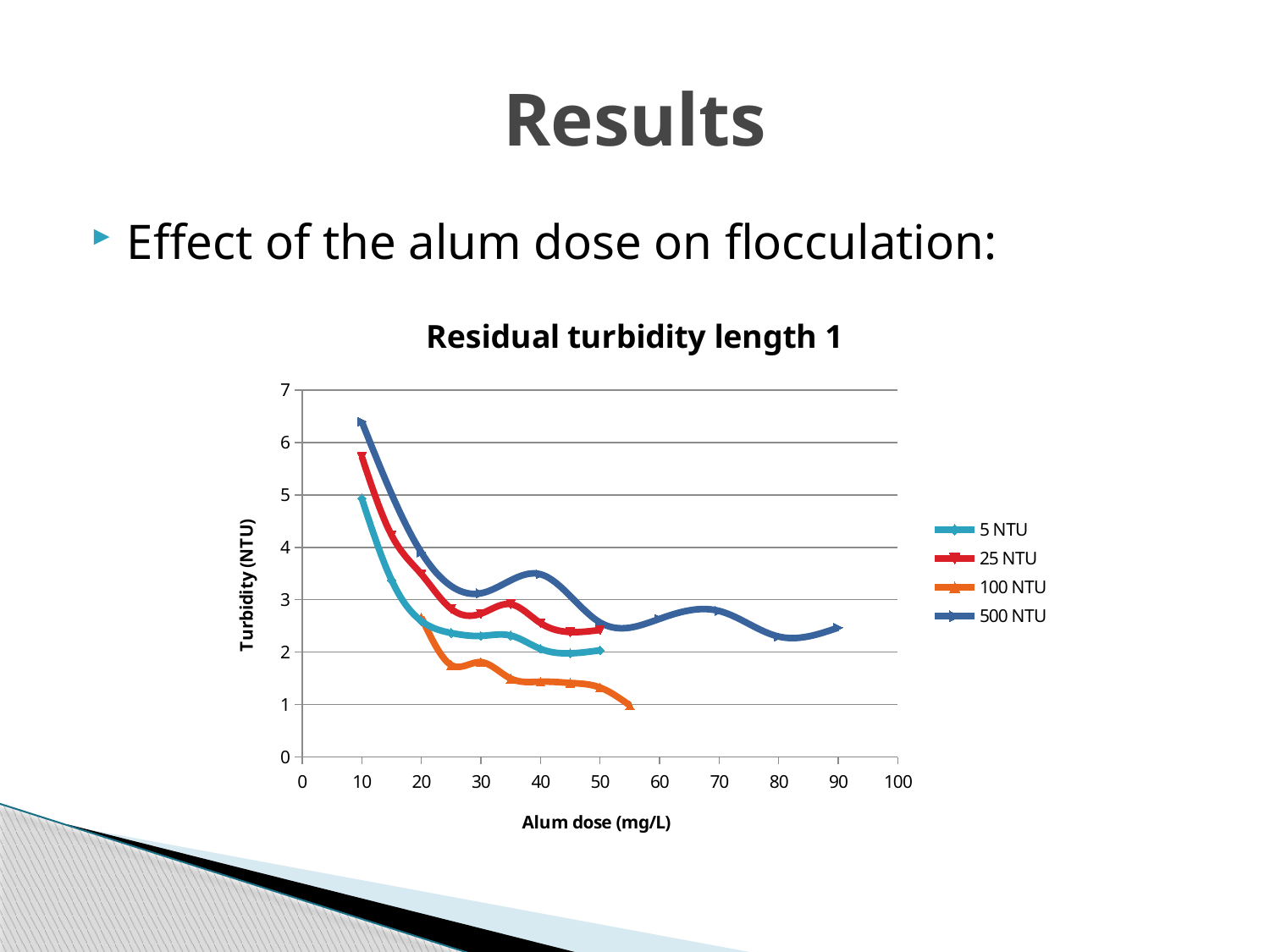
Is the turbidity for the 100 NTU series at an alum dose of 40 mg/L greater or less than 2? less Does the turbidity for the 5 NTU series rise or fall as the alum dose increases from 10 to 50 mg/L? fall What kind of chart is shown on the slide? line chart What is the label of the x axis? Alum dose (mg/L) Is the turbidity for the 25 NTU series at an alum dose of 10 mg/L greater or less than 5? greater Which series has the highest turbidity at an alum dose of 10 mg/L? 500 NTU At an alum dose of 20 mg/L, which series has the higher turbidity, 5 NTU or 25 NTU? 25 NTU How many series does the legend list? 4 Is the turbidity for the 500 NTU series at an alum dose of 10 mg/L greater or less than 6? greater What is the title of the chart? Residual turbidity length 1 Which series has the lowest turbidity at an alum dose of 40 mg/L? 100 NTU